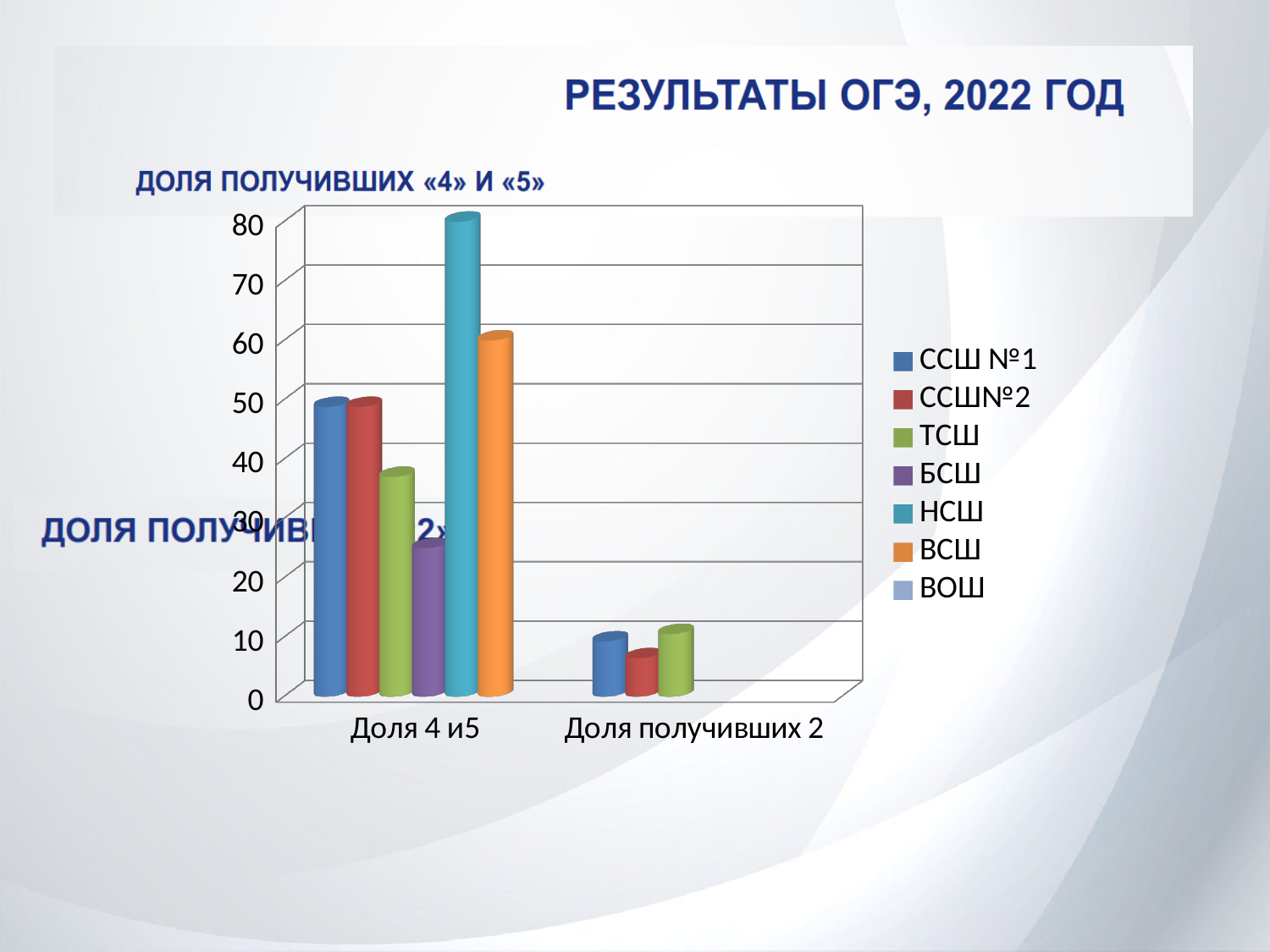
Is the value for НСШ in "Доля 4 и5" greater or less than 70? greater What kind of chart is shown on the slide? bar chart How many categories are shown on the x axis? 2 Is the value for БСШ in "Доля 4 и5" greater or less than 30? less Which school has the lowest plotted value in the "Доля 4 и5" category? БСШ Which school has the highest value in the "Доля 4 и5" category? НСШ Is the value for ССШ№2 in "Доля получивших 2" greater or less than 10? less What is the title at the top of the slide? РЕЗУЛЬТАТЫ ОГЭ, 2022 ГОД How many series does the legend list? 7 In the "Доля 4 и5" category, which is larger: ТСШ or БСШ? ТСШ In the "Доля 4 и5" category, which is larger: НСШ or ВСШ? НСШ